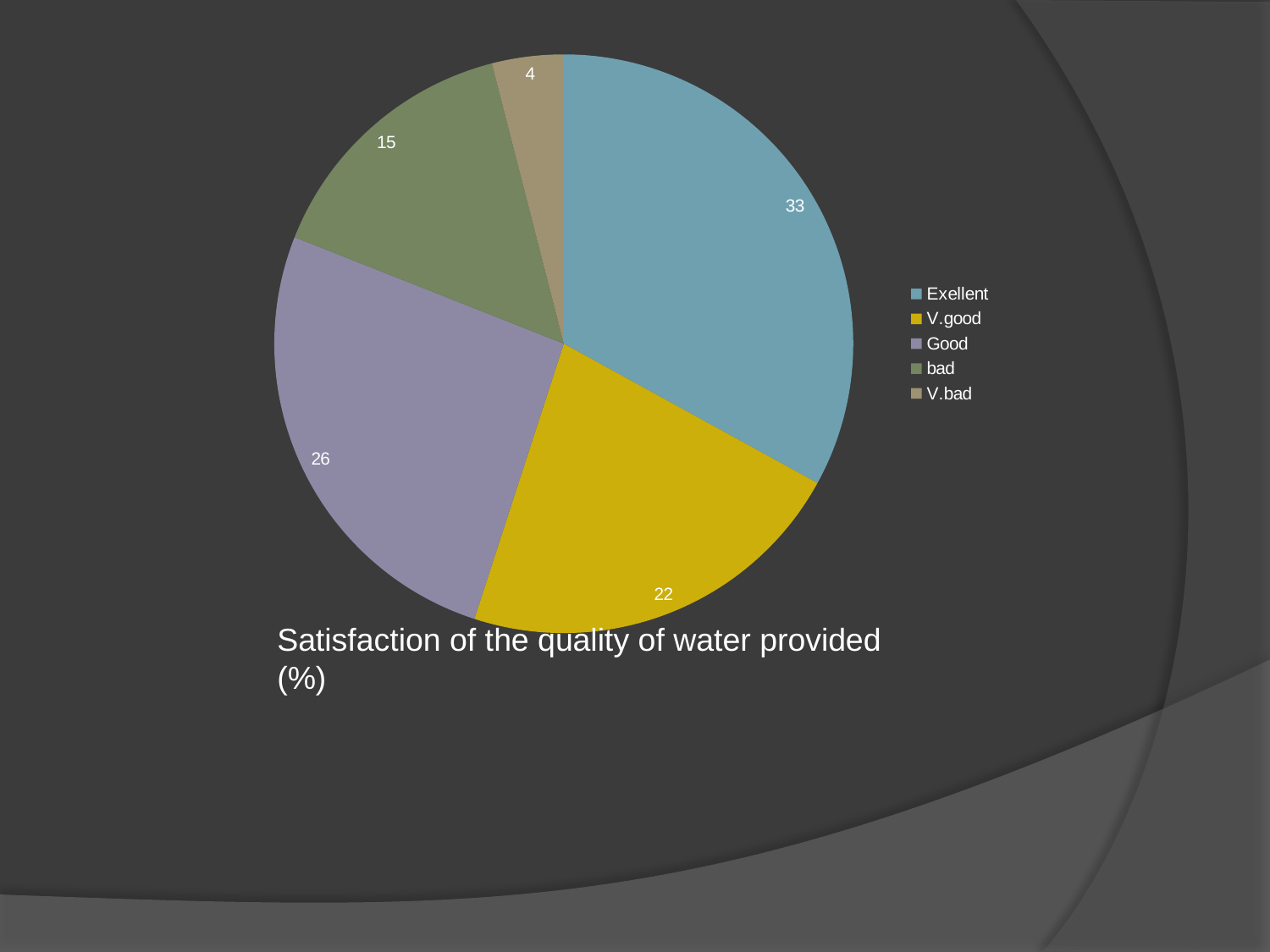
What kind of chart is shown on the slide? pie chart What is the value for Exellent? 33 Which category has the smallest slice? V.bad What is the difference between the values for Exellent and Good? 7 What is the value for V.good? 22 What is the title of the chart? Satisfaction of the quality of water provided (%) Which is larger, the value for Good or the value for V.good? Good What is the value for V.bad? 4 Which category has the largest slice? Exellent What is the value for Good? 26 How many categories does the legend list? 5 What is the value for bad? 15